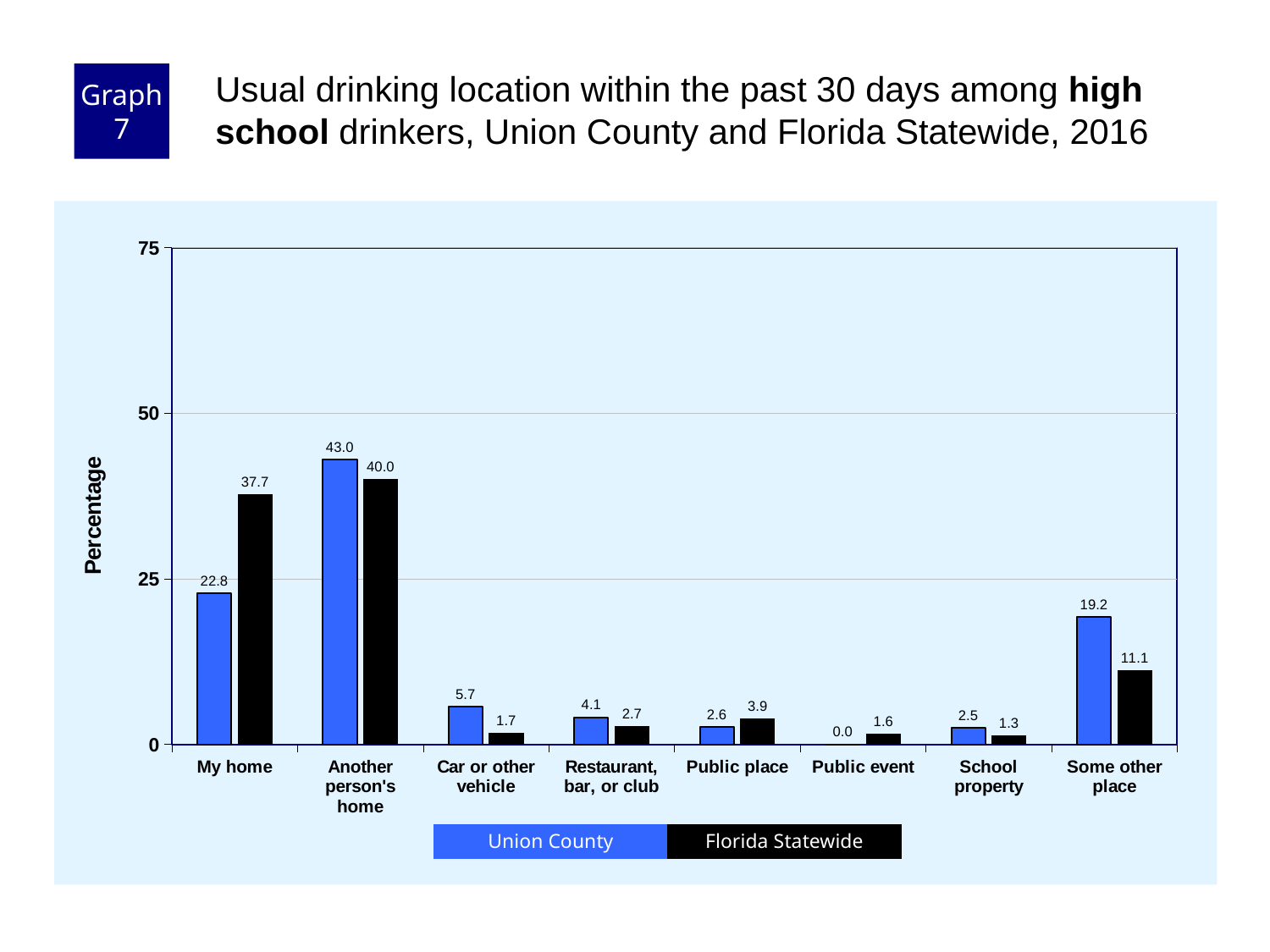
How many categories are shown on the x axis? 8 Which category has the lowest Florida Statewide value? School property Which is larger for "Public place": Union County or Florida Statewide? Florida Statewide Which category has the highest Union County value? Another person's home What is the Union County value for "Another person's home"? 43.0 What is the difference between the Union County and Florida Statewide values for "Some other place"? 8.1 Is the Union County value for "My home" greater or less than 25? less What kind of chart is shown on the slide? Bar chart What is the label of the y axis? Percentage What is the Florida Statewide value for "My home"? 37.7 How many series does the legend list? 2 What is the Union County value for "Public event"? 0.0